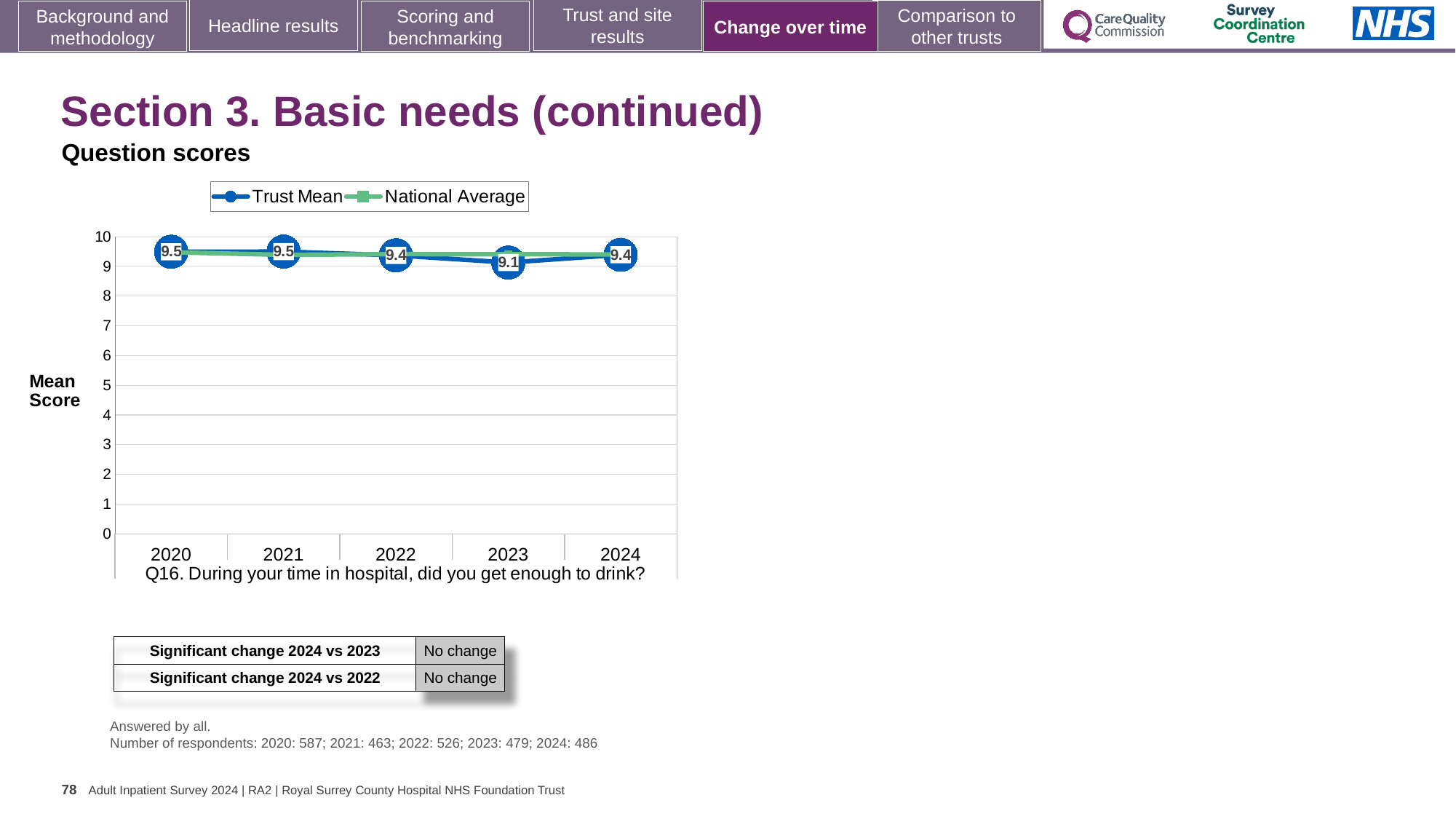
What is the Trust Mean score for 2023? 9.1 What kind of chart is shown on the slide? Line chart Which year has the higher Trust Mean score, 2022 or 2023? 2022 What is the Trust Mean score for 2020? 9.5 In which year is the Trust Mean score lowest? 2023 Does the Trust Mean score rise or fall from 2021 to 2023? Fall What is the Trust Mean score for 2024? 9.4 How many years are plotted on the x axis? 5 Which survey question does the chart show scores for? Q16. During your time in hospital, did you get enough to drink? What is the difference between the Trust Mean scores for 2021 and 2023? 0.4 How many series does the legend list? 2 Is the National Average value for 2023 greater or less than 9? greater